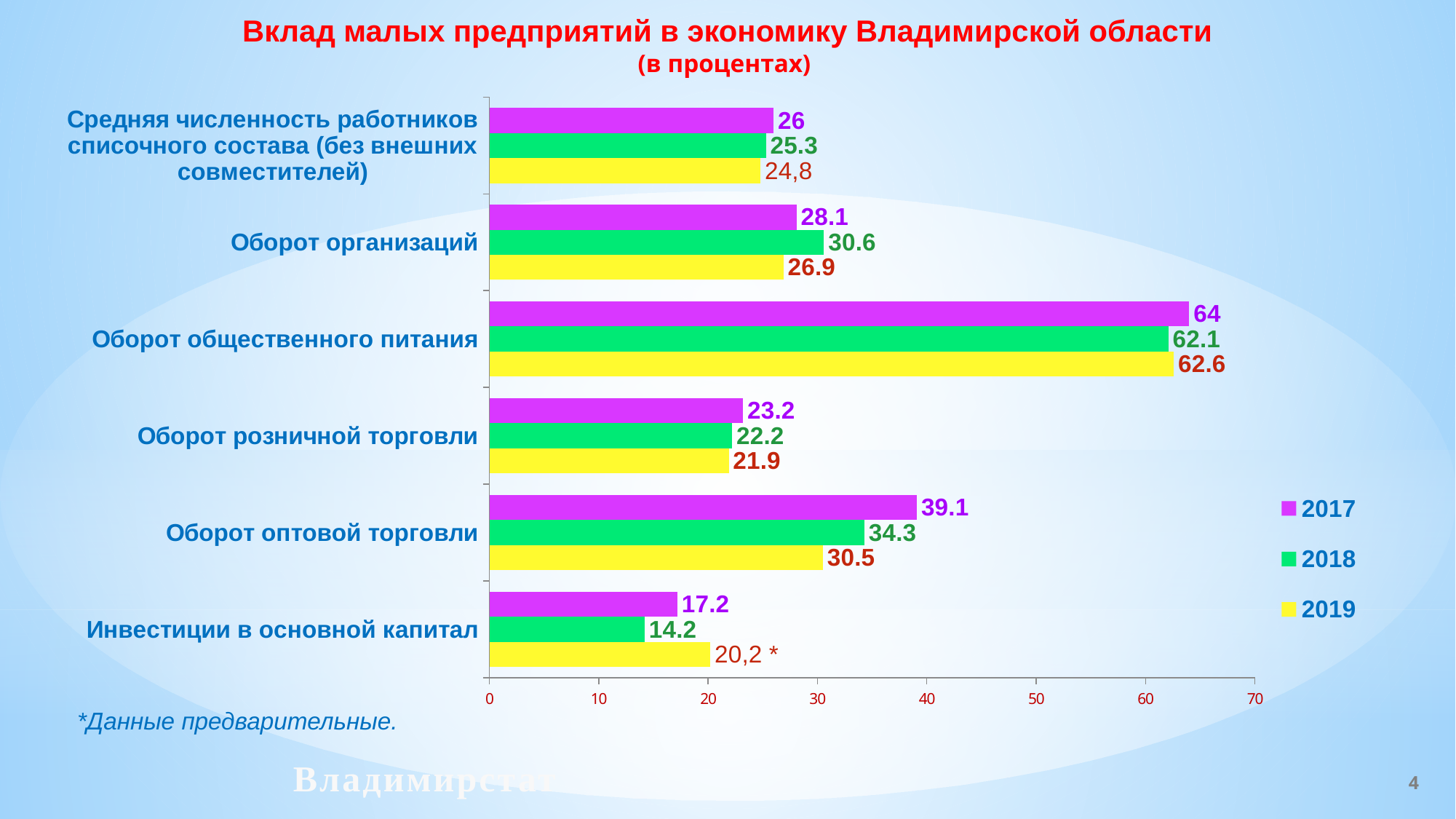
What is the 2018 value for Оборот оптовой торговли? 34.3 Which category has the lowest 2018 value? Инвестиции в основной капитал For Оборот организаций, which year has the larger value, 2017 or 2018? 2018 Which colour represents the 2019 series in the legend? yellow What type of chart is shown on the slide? bar chart What is the 2017 value for Оборот общественного питания? 64 How many categories are shown on the chart? 6 What is the 2019 value for Оборот организаций? 26.9 How many series does the legend list? 3 Which category has the highest 2017 value? Оборот общественного питания What is the 2019 value for Инвестиции в основной капитал? 20,2 What is the difference between the 2017 and 2019 values for Оборот оптовой торговли? 8.6